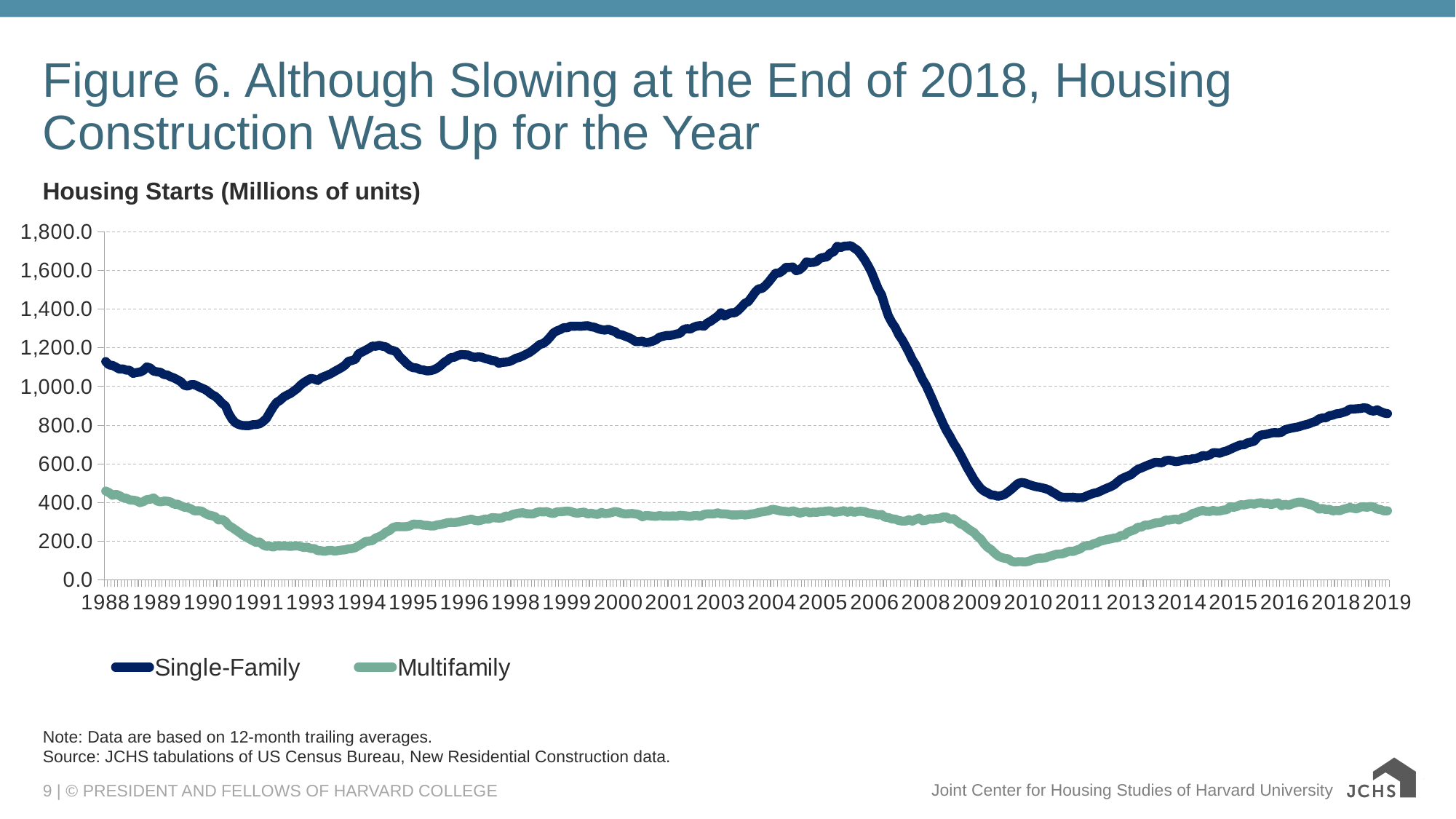
Around which year does the Multifamily series reach its lowest value? 2010 Is the peak value of the Single-Family series greater or less than 1,600? greater What is the axis title shown above the chart? Housing Starts (Millions of units) How many series does the legend list? 2 Which series reaches the highest value on the chart? Single-Family Is the value for Multifamily in 2010 greater or less than 200? less In 2005, which series has the larger value, Single-Family or Multifamily? Single-Family What are the two series named in the legend? Single-Family and Multifamily Is the value for Single-Family in 1988 greater or less than 1,000? greater Does the Single-Family series rise or fall between 2006 and 2009? fall What kind of chart is shown on the slide? line chart